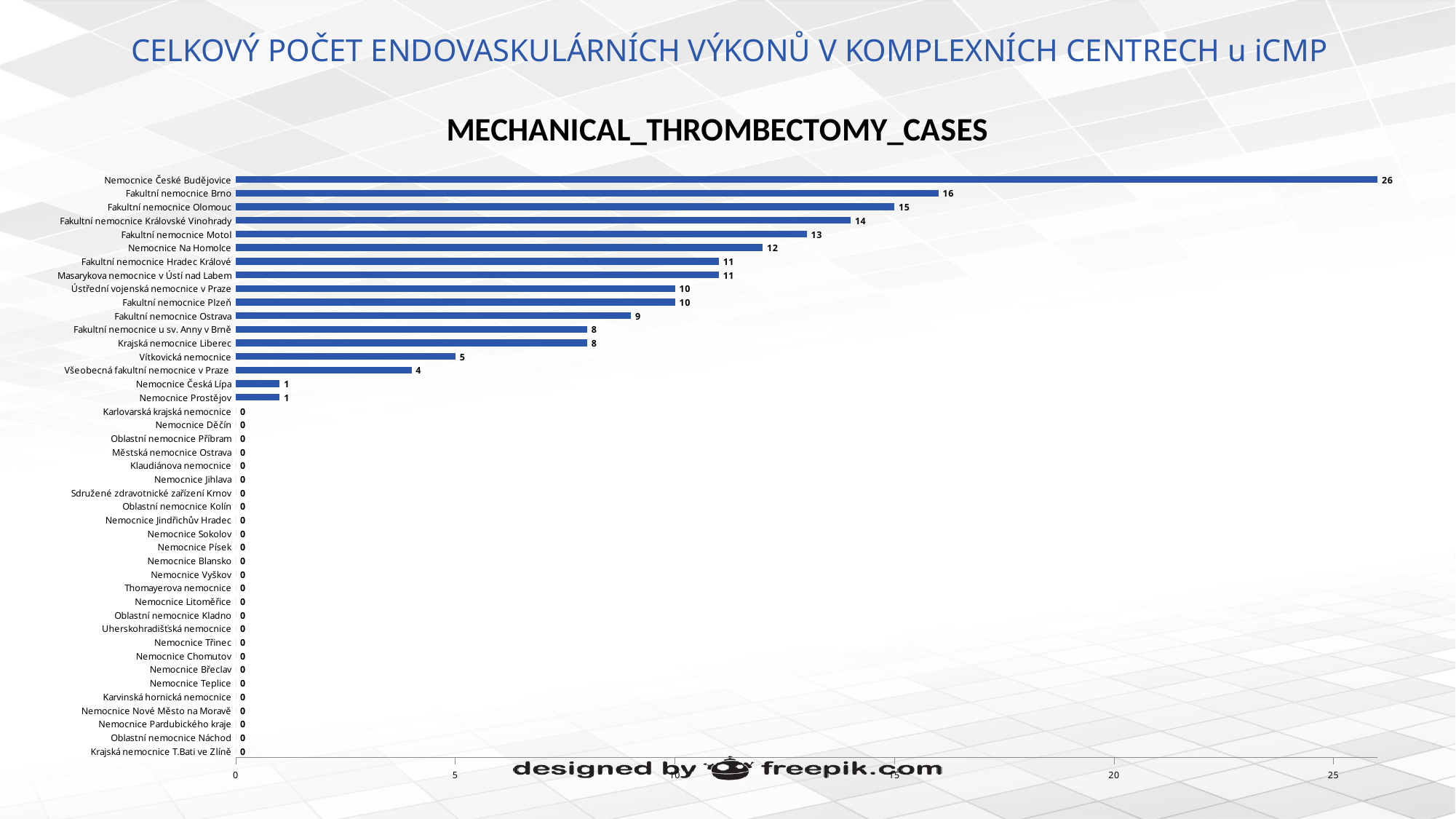
Is the value for Fakultní nemocnice Královské Vinohrady greater or less than 10? greater What is the value for Nemocnice Prostějov? 1 Which is larger, the value for Nemocnice Na Homolce or the value for Fakultní nemocnice Ostrava? Nemocnice Na Homolce What is the difference between the values for Nemocnice České Budějovice and Fakultní nemocnice Brno? 10 Which hospital has the highest number of mechanical thrombectomy cases? Nemocnice České Budějovice What is the value for Nemocnice České Budějovice? 26 How many hospitals have a value of 0 on the chart? 26 What is the title of the chart? MECHANICAL_THROMBECTOMY_CASES What is the difference between the values for Fakultní nemocnice Olomouc and Vítkovická nemocnice? 10 What is the value for Fakultní nemocnice Motol? 13 What kind of chart is shown on the slide? bar chart What is the value for Krajská nemocnice Liberec? 8